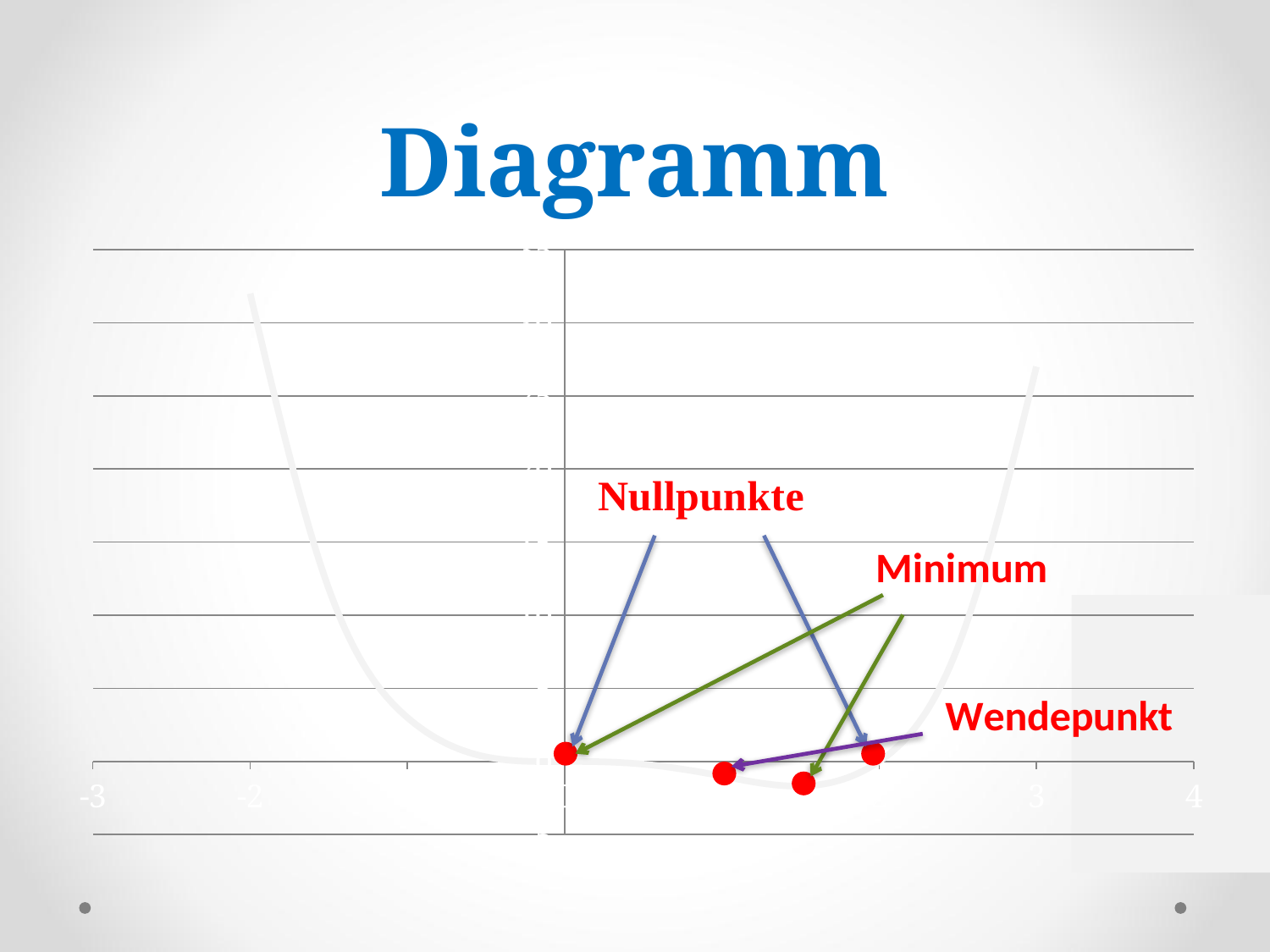
Which annotation label points to the lowest red point on the curve? Minimum Does the curve rise or fall as x goes from -2 toward the y-axis? fall How many labelled annotations (text labels with arrows) point to the curve? 3 Does the curve rise or fall as x approaches 3 from the minimum? rise What is the title of the slide containing the chart? Diagramm Which annotation label is written in blue-arrowed text at the top of the annotations? Nullpunkte What is the highest x-axis label shown on the chart? 4 What kind of chart is shown on the slide? line chart What is the lowest x-axis label shown on the chart? -3 How many red points are marked on the curve? 4